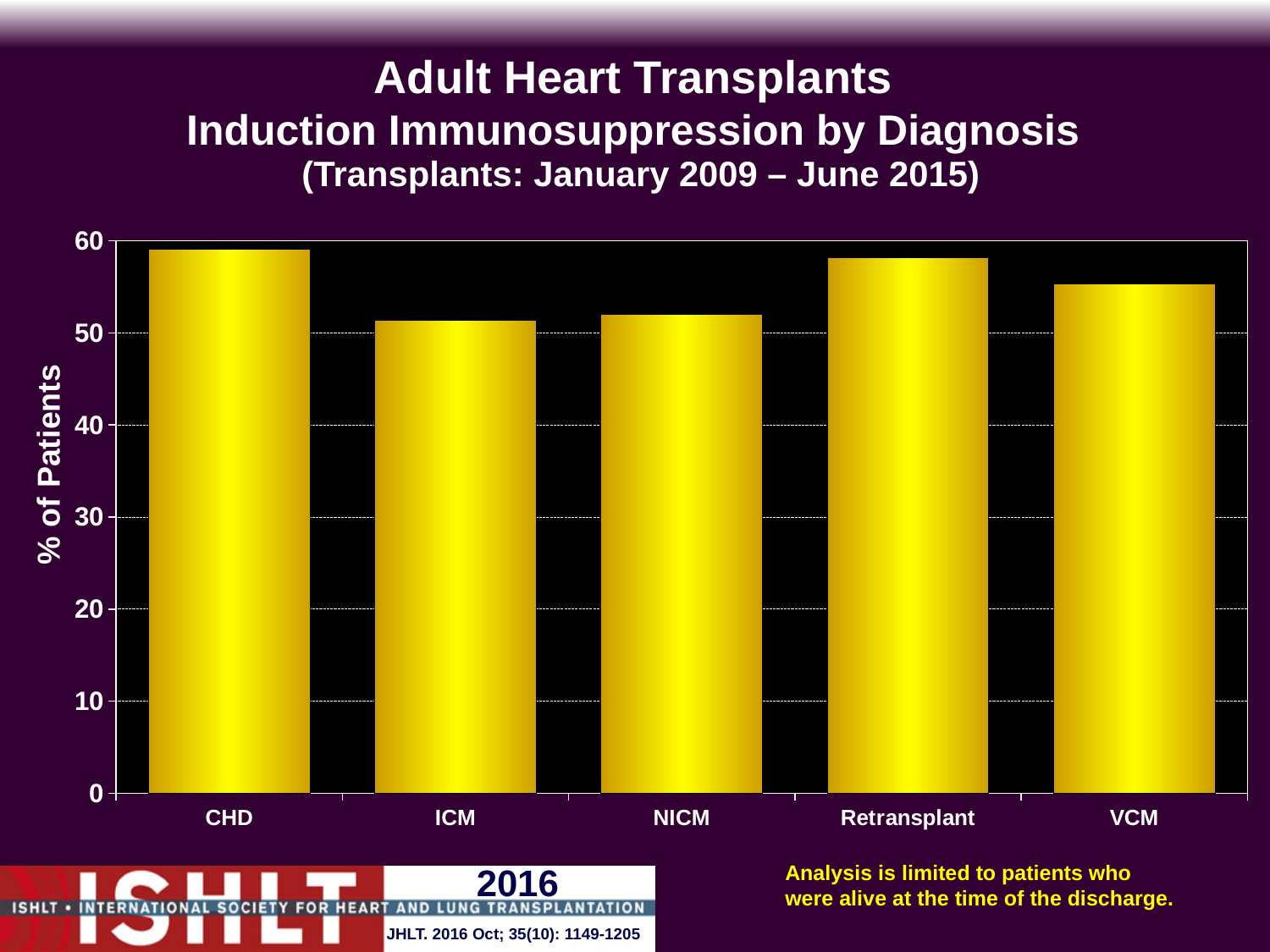
How many diagnosis categories are shown on the x axis? 5 What kind of chart is shown on the slide? bar chart Which has the larger value, CHD or ICM? CHD Is the value for CHD greater or less than 50? greater What time period of transplants does the chart title say is covered? January 2009 – June 2015 Is the value for VCM greater or less than 50? greater Which has the larger value, NICM or VCM? VCM What is the label on the y axis? % of Patients Is the value for NICM greater or less than 50? greater Which has the larger value, Retransplant or ICM? Retransplant